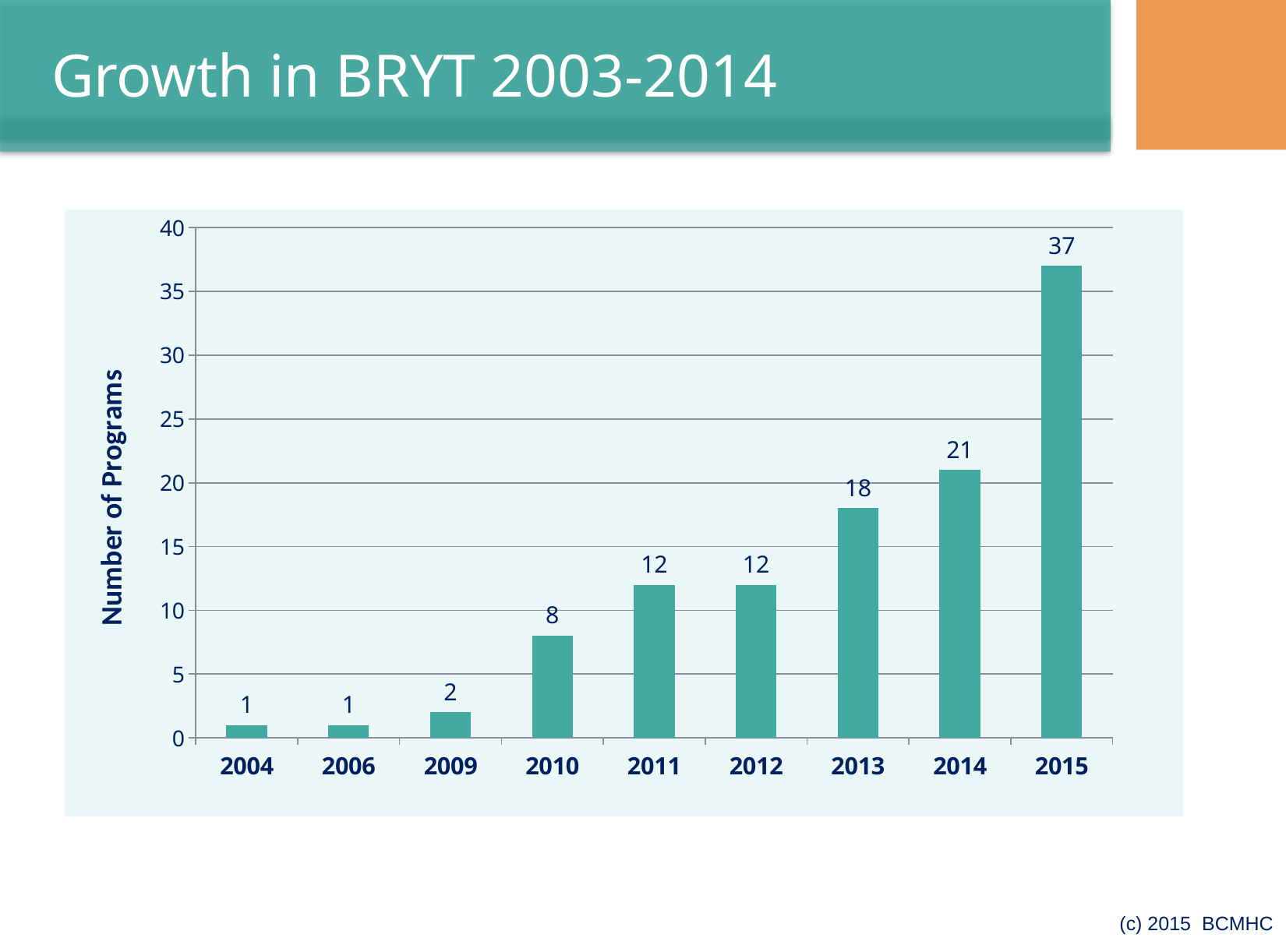
Is the number of programs in 2014 greater or less than 20? greater What kind of chart is shown on the slide? bar chart What is the difference in the number of programs between 2013 and 2012? 6 Which two years both have 12 programs? 2011 and 2012 Which year has the highest number of programs? 2015 How many years are shown on the x axis? 9 Do the number of programs generally rise or fall from 2004 to 2015? rise What is the number of programs in 2010? 8 What is the number of programs in 2015? 37 What is the difference in the number of programs between 2015 and 2014? 16 What is the label of the y axis? Number of Programs Which year has more programs, 2013 or 2011? 2013